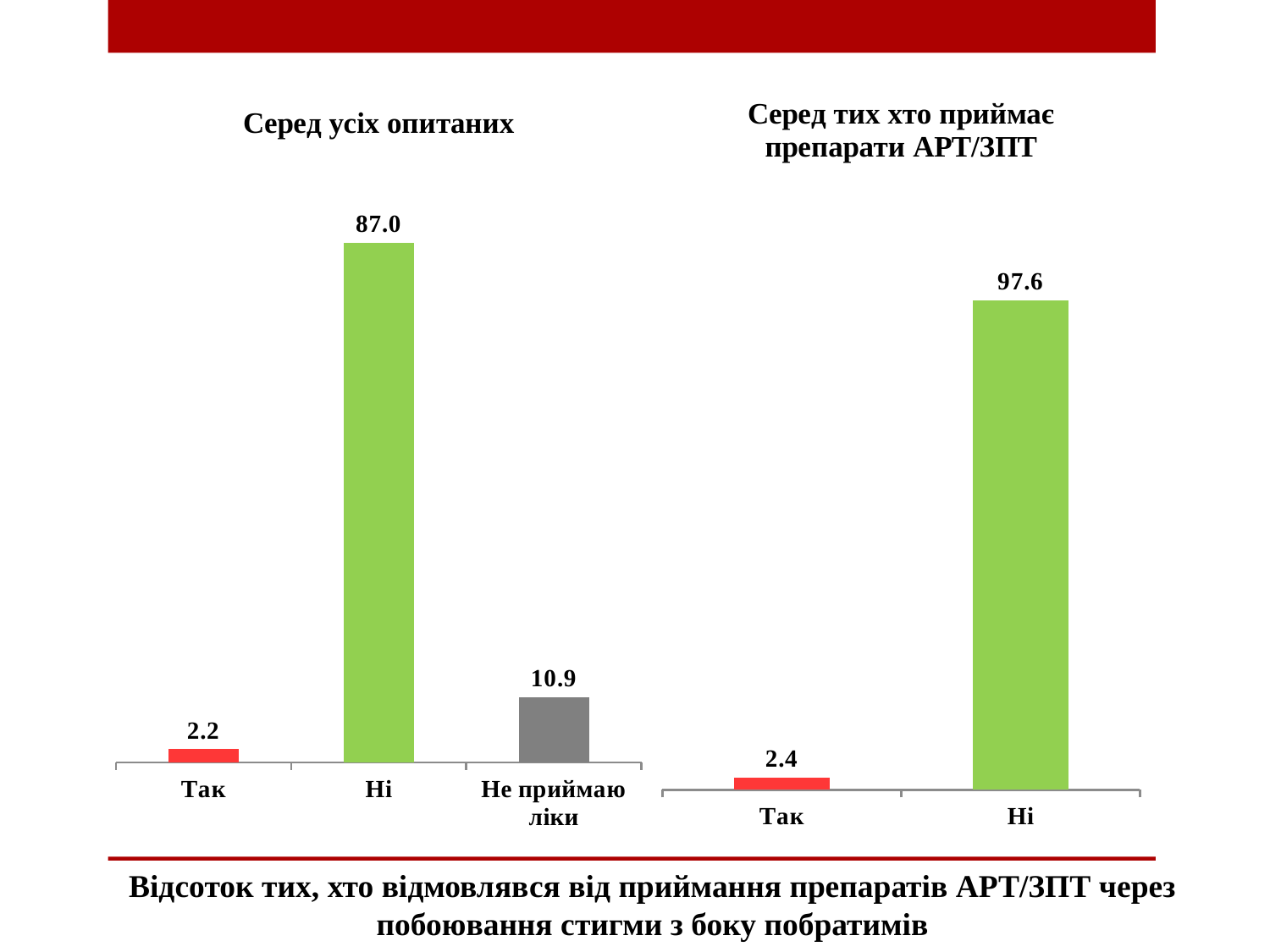
How many categories are shown in the chart titled "Серед тих хто приймає препарати АРТ/ЗПТ"? 2 In the chart titled "Серед тих хто приймає препарати АРТ/ЗПТ", what is the difference between the values for "Ні" and "Так"? 95.2 Which is larger: the value for "Так" in the chart titled "Серед усіх опитаних" or the value for "Так" in the chart titled "Серед тих хто приймає препарати АРТ/ЗПТ"? Серед тих хто приймає препарати АРТ/ЗПТ In the chart titled "Серед усіх опитаних", which category has the lowest value? Так In the chart titled "Серед усіх опитаних", what is the value for "Не приймаю ліки"? 10.9 In the chart titled "Серед усіх опитаних", what is the value for "Ні"? 87.0 In the chart titled "Серед усіх опитаних", which category has the highest value? Ні In the chart titled "Серед тих хто приймає препарати АРТ/ЗПТ", what is the value for "Ні"? 97.6 How many categories are shown in the chart titled "Серед усіх опитаних"? 3 In the chart titled "Серед усіх опитаних", what is the difference between the values for "Ні" and "Не приймаю ліки"? 76.1 In the chart titled "Серед тих хто приймає препарати АРТ/ЗПТ", what is the value for "Так"? 2.4 What kind of chart is the chart titled "Серед усіх опитаних"? Bar chart